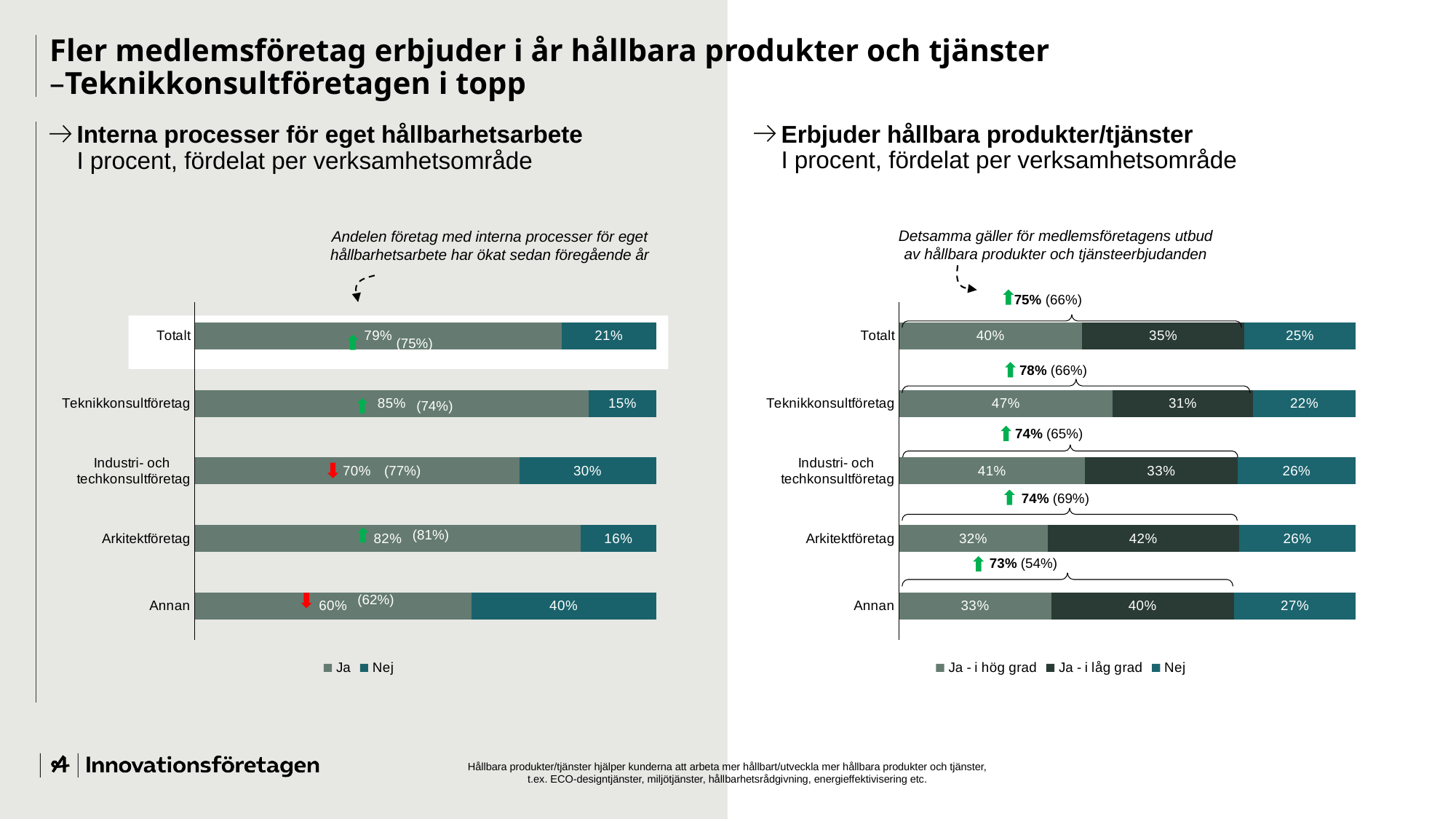
What kind of chart is 'Erbjuder hållbara produkter/tjänster'? Stacked bar chart In the chart 'Erbjuder hållbara produkter/tjänster', which category has the highest 'Ja - i låg grad' value? Arkitektföretag In the chart 'Interna processer för eget hållbarhetsarbete', what is the 'Nej' value for Annan? 40% In the chart 'Erbjuder hållbara produkter/tjänster', how many series does the legend list? 3 In the chart 'Interna processer för eget hållbarhetsarbete', what is the difference between the 'Ja' values for Teknikkonsultföretag and Industri- och techkonsultföretag? 15 percentage points In the chart 'Interna processer för eget hållbarhetsarbete', which category has the lowest 'Ja' value? Annan In the chart 'Erbjuder hållbara produkter/tjänster', what is the 'Ja - i hög grad' value for Teknikkonsultföretag? 47% In the chart 'Erbjuder hållbara produkter/tjänster', is the 'Ja - i hög grad' value for Totalt larger or smaller than the 'Ja - i hög grad' value for Arkitektföretag? larger In the chart 'Interna processer för eget hållbarhetsarbete', what is the 'Ja' value for Teknikkonsultföretag? 85% In the chart 'Interna processer för eget hållbarhetsarbete', how many series does the legend list? 2 In the chart 'Interna processer för eget hållbarhetsarbete', which category has the highest 'Ja' value? Teknikkonsultföretag In the chart 'Erbjuder hållbara produkter/tjänster', what is the 'Nej' value for Annan? 27%